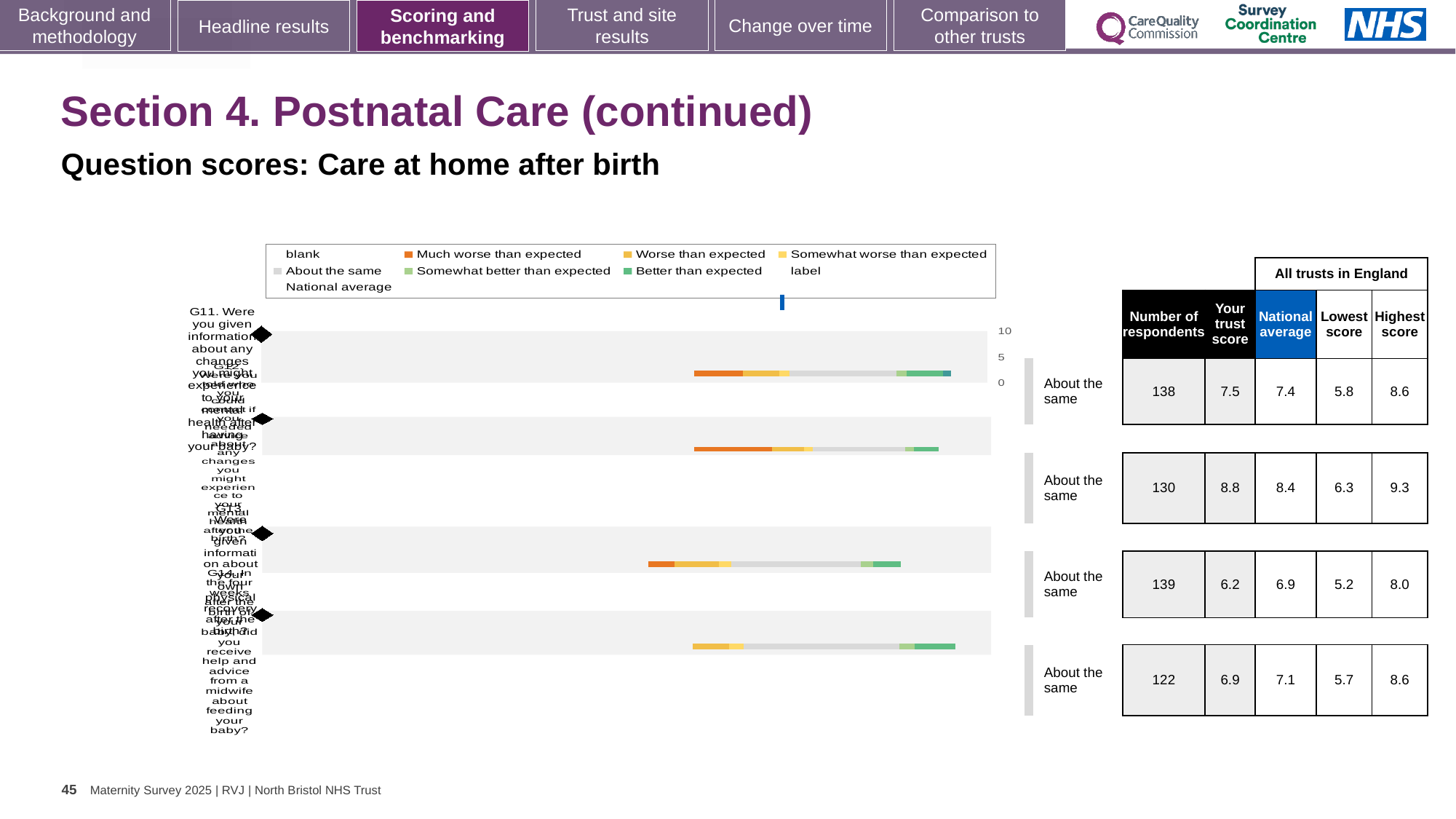
In the table beside the chart, what is the highest 'Your trust score' value across the four rows? 8.8 Which colour in the legend represents 'Much worse than expected'? orange In the table beside the chart, what is 'Your trust score' for the top row (G11)? 7.5 In the table beside the chart, what is the 'National average' for the top row (G11)? 7.4 In the table beside the chart, what is the 'Highest score' for the bottom row? 8.6 In the table beside the chart, which is larger for the second row: 'Your trust score' or 'National average'? Your trust score What is the highest tick value shown on the chart's axis? 10 How many question bars are plotted in the chart? 4 In the table beside the chart, what is the 'Number of respondents' for the second row? 130 In the table beside the chart, what is the difference between 'Your trust score' and 'National average' for the second row? 0.4 What kind of chart is shown on the slide? bar chart In the table beside the chart, what is the lowest 'Your trust score' value across the four rows? 6.2